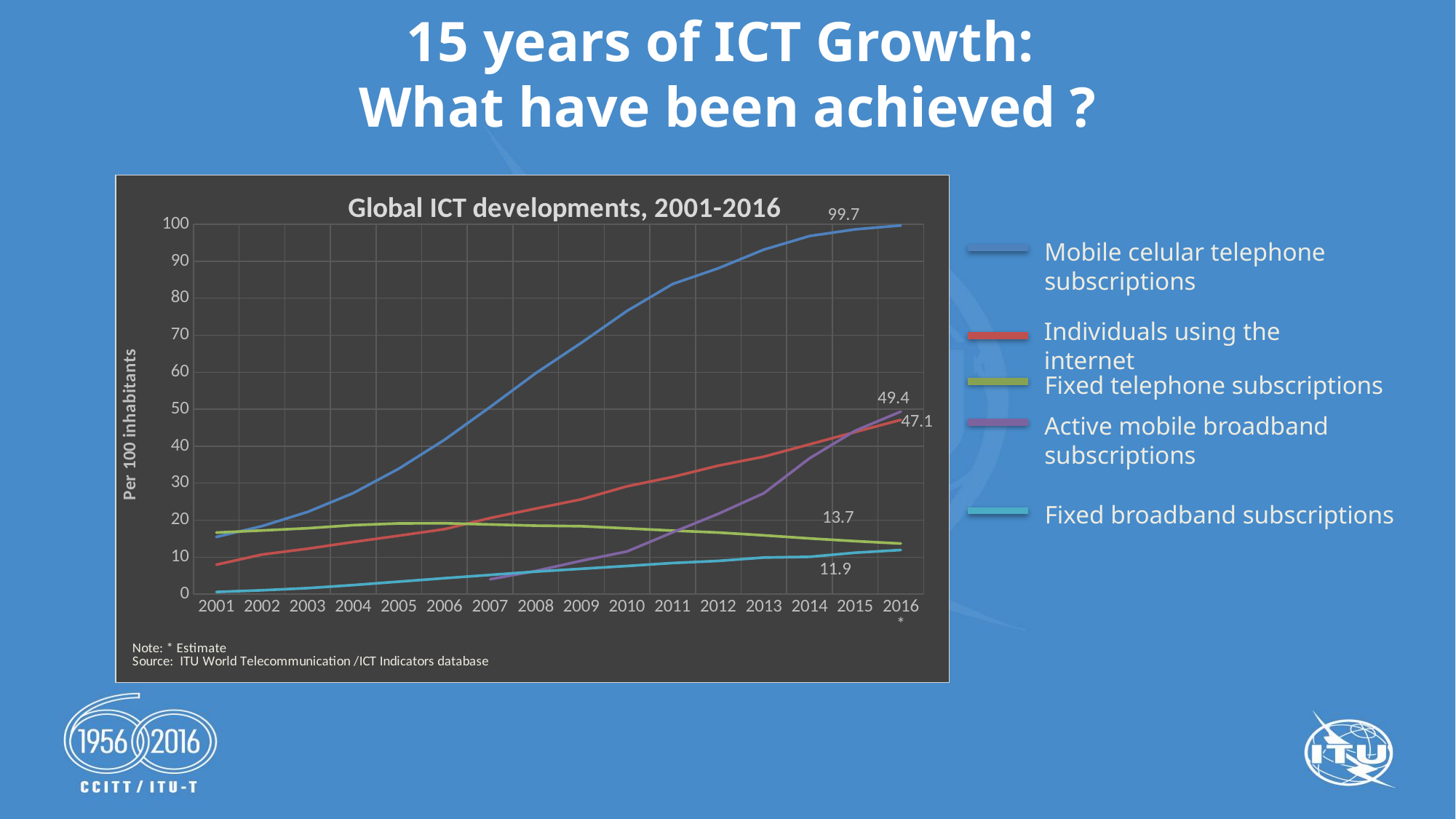
Which series has the highest value in 2016? Mobile celular telephone subscriptions Is the value for Mobile celular telephone subscriptions in 2011 greater or less than 80? greater Does the Fixed telephone subscriptions series rise or fall between 2006 and 2016? Fall What is the value for Active mobile broadband subscriptions in 2016? 49.4 What is the difference between Mobile celular telephone subscriptions and Active mobile broadband subscriptions in 2016? 50.3 What is the value for Mobile celular telephone subscriptions in 2016? 99.7 What is the value for Individuals using the internet in 2016? 47.1 What type of chart is shown on the slide? Line chart What is the title of the chart? Global ICT developments, 2001-2016 What is the value for Fixed broadband subscriptions in 2016? 11.9 How many series does the legend list? 5 What is the value for Fixed telephone subscriptions in 2016? 13.7